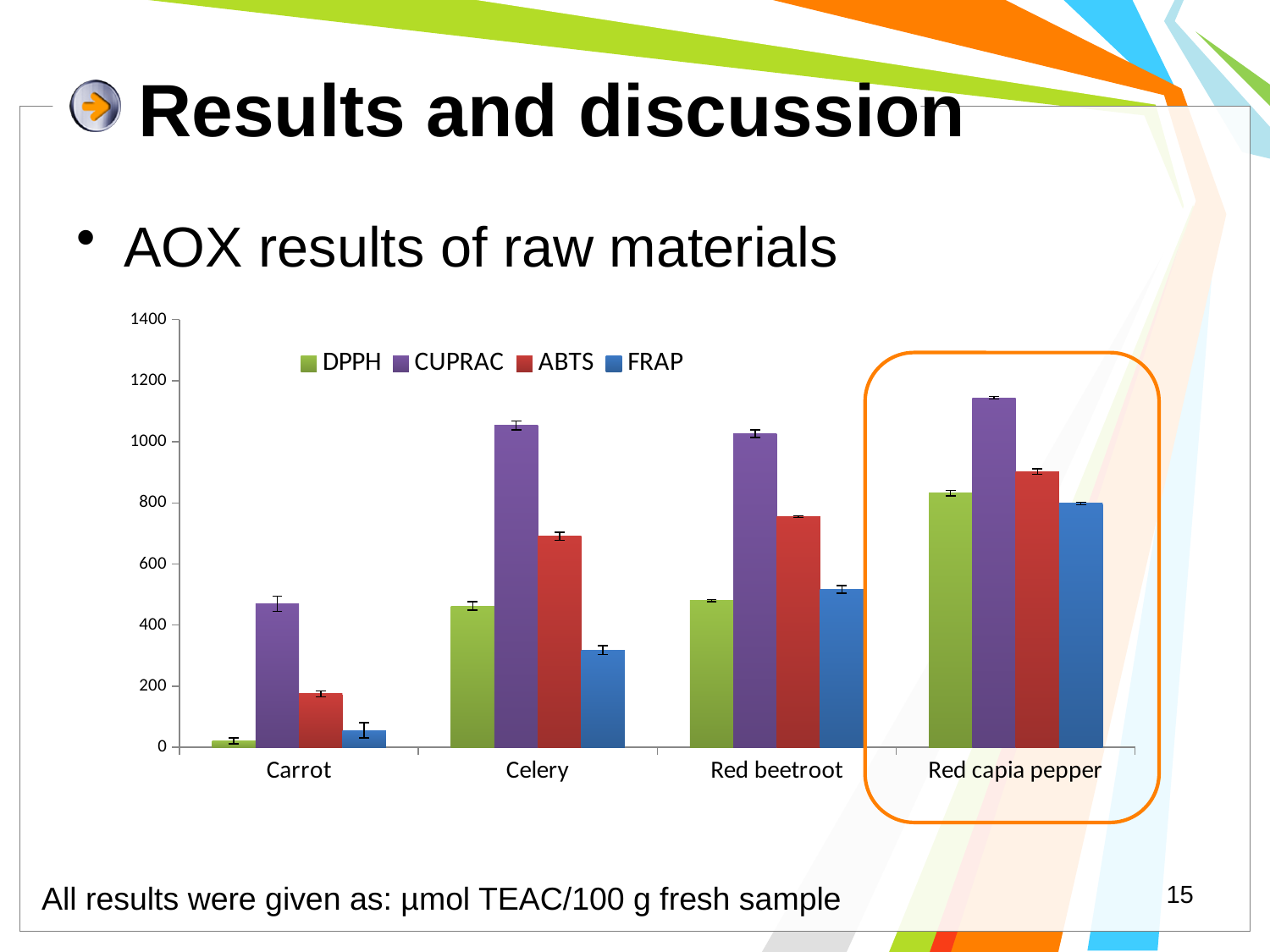
Which category on the chart is highlighted with an orange rounded box? Red capia pepper Which has the larger ABTS value, Celery or Red beetroot? Red beetroot Which raw material has the lowest CUPRAC value? Carrot How many series does the legend list? 4 Is the ABTS value for Red capia pepper greater or less than 800? greater For Carrot, which series has the lowest value? DPPH Which has the larger FRAP value, Celery or Red beetroot? Red beetroot Which raw material has the highest CUPRAC value? Red capia pepper Is the CUPRAC value for Celery greater or less than 1000? greater What kind of chart is shown on the slide? bar chart Is the FRAP value for Carrot greater or less than 200? less How many raw material categories are shown on the x axis? 4